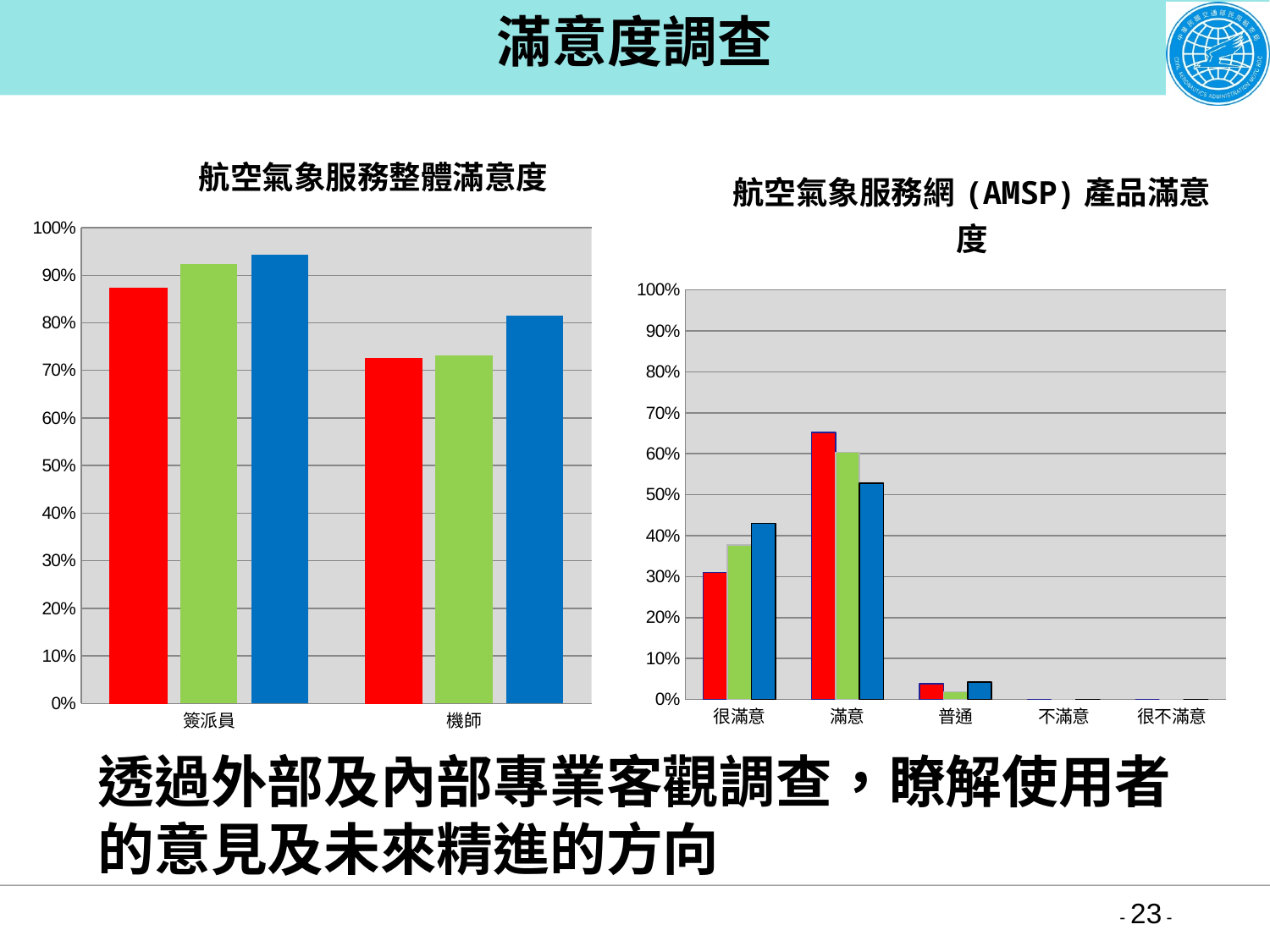
In the right chart (航空氣象服務網（AMSP）產品滿意度), is the red bar for 滿意 greater or less than 60%? greater In the left chart (航空氣象服務整體滿意度), is the red bar for 簽派員 greater or less than 80%? greater In the left chart (航空氣象服務整體滿意度), is the red bar for 機師 greater or less than 80%? less How many categories are shown on the x axis of the right chart (航空氣象服務網（AMSP）產品滿意度)? 5 What type of chart is the left chart titled 航空氣象服務整體滿意度? bar chart In the left chart (航空氣象服務整體滿意度), which category has the higher blue bar, 簽派員 or 機師? 簽派員 In the right chart (航空氣象服務網（AMSP）產品滿意度), which category has the tallest bars? 滿意 What is the title of the left chart on the slide? 航空氣象服務整體滿意度 What type of chart is the right chart titled 航空氣象服務網（AMSP）產品滿意度? bar chart In the left chart (航空氣象服務整體滿意度), how many bars are plotted for each category? 3 How many categories are shown on the x axis of the left chart (航空氣象服務整體滿意度)? 2